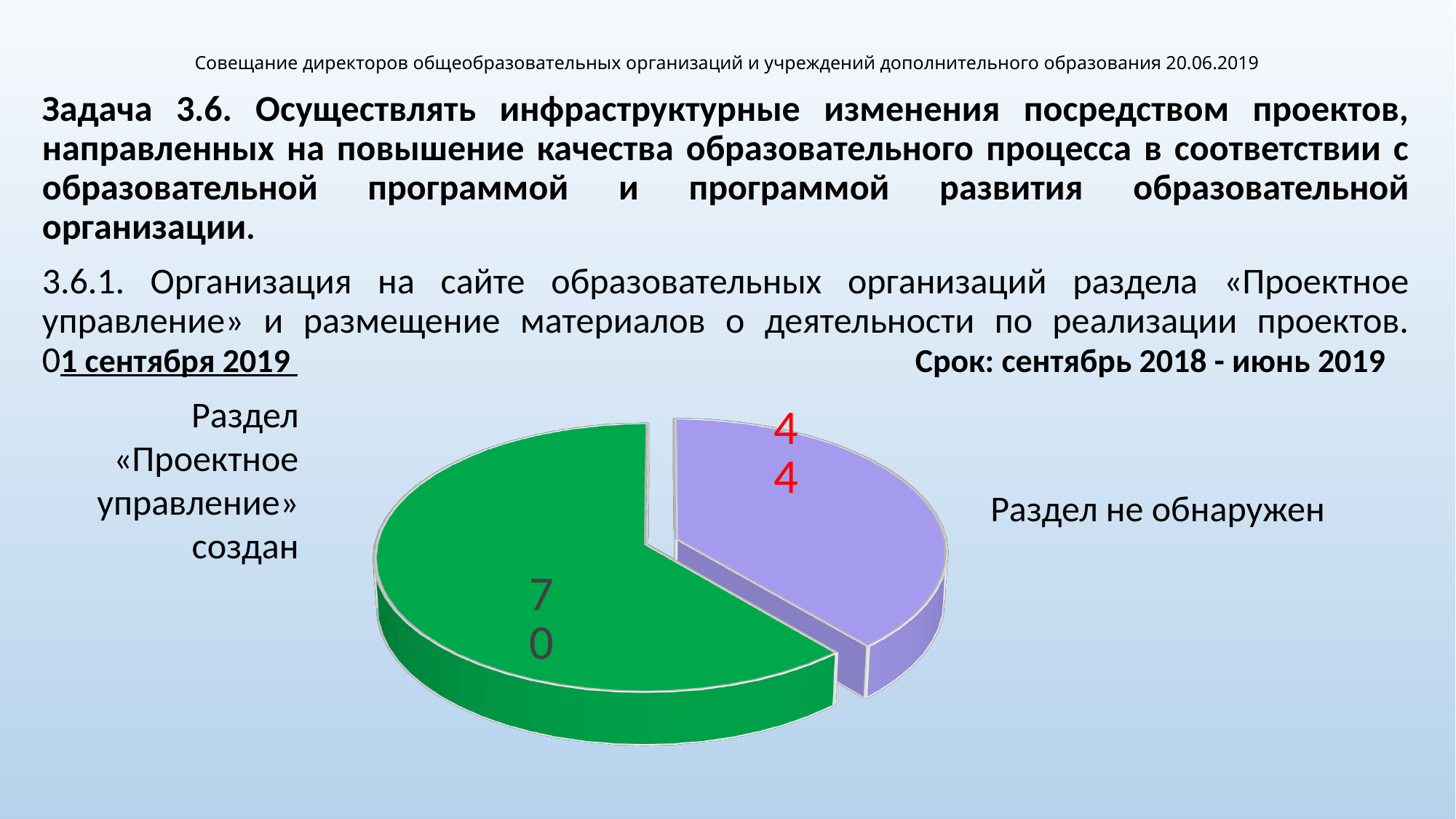
How many slices does the pie chart have? 2 What colour is the slice for «Раздел не обнаружен»? Purple What is the difference between the value for «Раздел «Проектное управление» создан» and the value for «Раздел не обнаружен»? 26 Which category has the smallest slice of the pie? Раздел не обнаружен What is the total of the two values shown in the pie chart? 114 What colour is the slice for «Раздел «Проектное управление» создан»? Green Which is larger: the value for «Раздел «Проектное управление» создан» or the value for «Раздел не обнаружен»? Раздел «Проектное управление» создан What value is shown for the slice labelled «Раздел не обнаружен»? 44 Which category has the largest slice of the pie? Раздел «Проектное управление» создан What value is shown for the slice labelled «Раздел «Проектное управление» создан»? 70 What kind of chart is shown on the slide? Pie chart